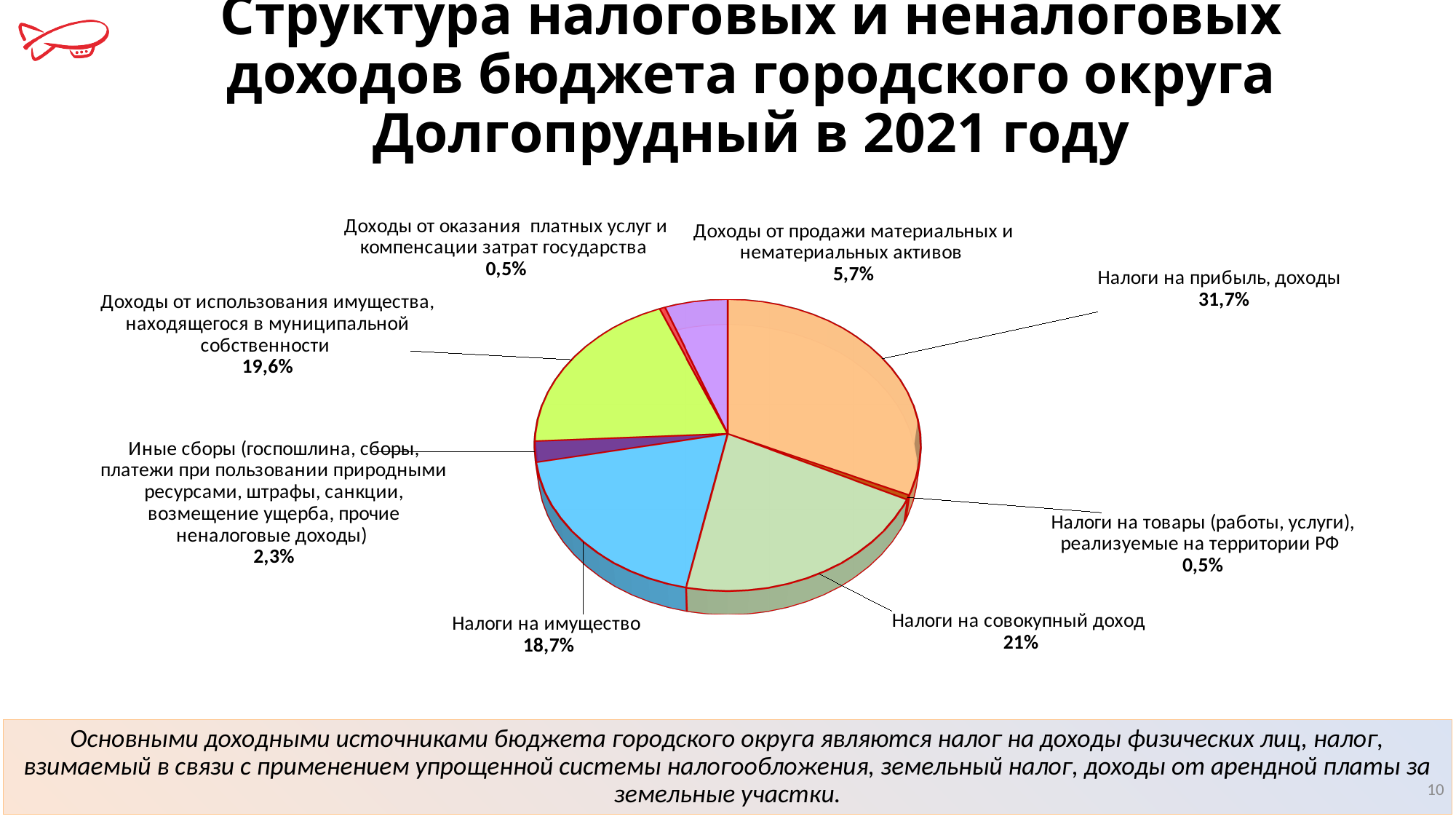
What type of chart is shown on the slide? Pie chart What is the value shown for "Иные сборы (госпошлина, сборы, платежи при пользовании природными ресурсами, штрафы, санкции, возмещение ущерба, прочие неналоговые доходы)"? 2,3% What share is shown for "Налоги на товары (работы, услуги), реализуемые на территории РФ"? 0,5% By how many percentage points does "Налоги на прибыль, доходы" exceed "Налоги на совокупный доход"? 10,7 Which is larger: "Доходы от использования имущества, находящегося в муниципальной собственности" or "Налоги на имущество"? Доходы от использования имущества, находящегося в муниципальной собственности Which year does the chart title refer to? 2021 What is the value shown for "Налоги на имущество"? 18,7% Which category has the largest share of the pie? Налоги на прибыль, доходы How many slices does the pie chart have? 8 What is the value for "Доходы от продажи материальных и нематериальных активов"? 5,7% What share of revenues does "Налоги на прибыль, доходы" account for? 31,7% What percentage is shown for "Доходы от использования имущества, находящегося в муниципальной собственности"? 19,6%